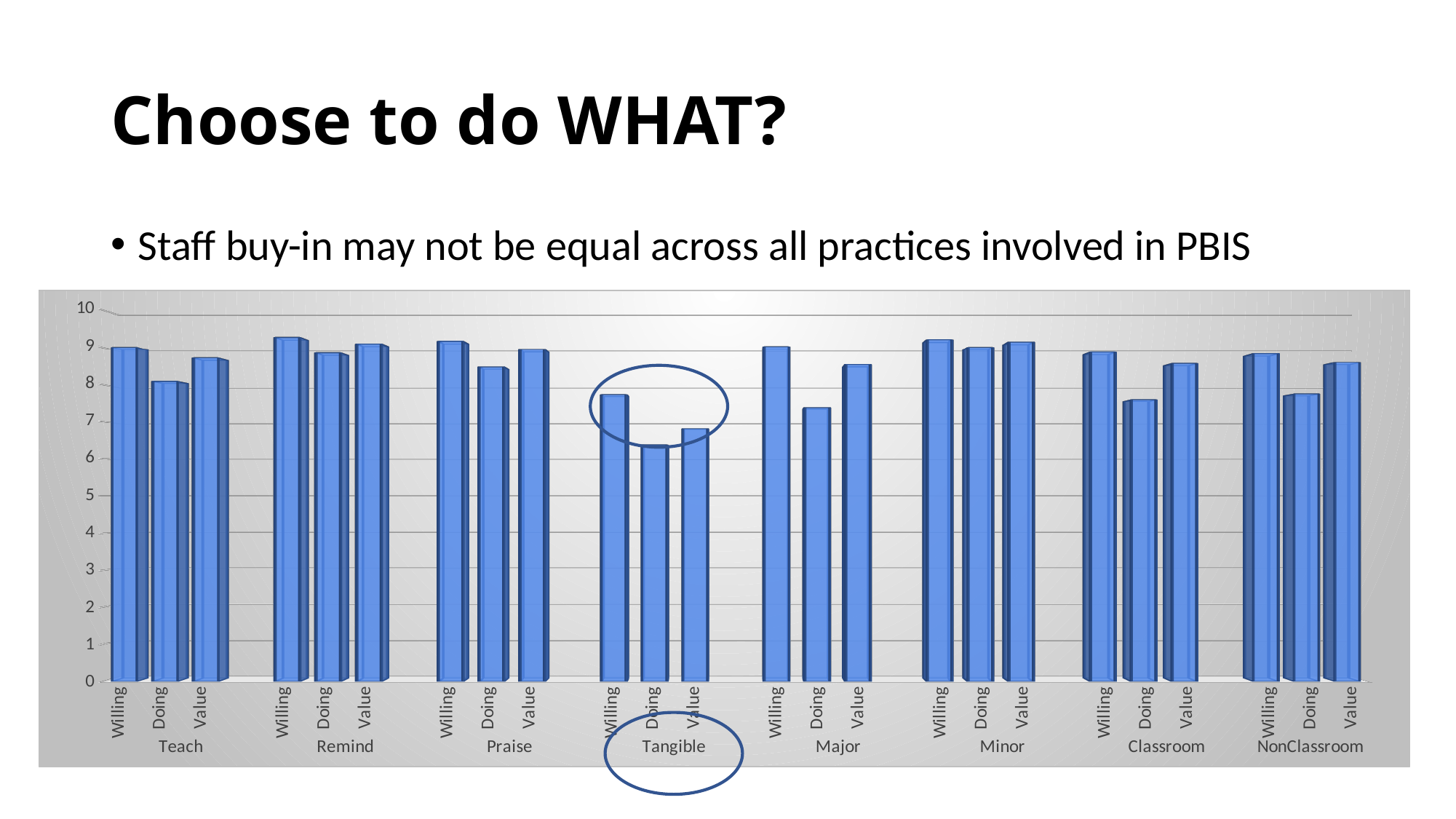
Which bar in the chart is the lowest? Tangible Doing Is the value for Doing under Tangible greater or less than 7? less Is the value for Doing under Major greater or less than 8? less Which is larger, the Doing value for Tangible or the Doing value for Major? Major How many bars are shown for each practice group in the chart? 3 How many practice groups are shown along the x axis of the chart? 8 Is the value for Willing under Tangible greater or less than 7? greater Within the Teach group, which is larger, Willing or Doing? Willing Within the Classroom group, which is larger, Doing or Value? Value What kind of chart is shown on the slide? bar chart Which practice group on the chart is circled? Tangible